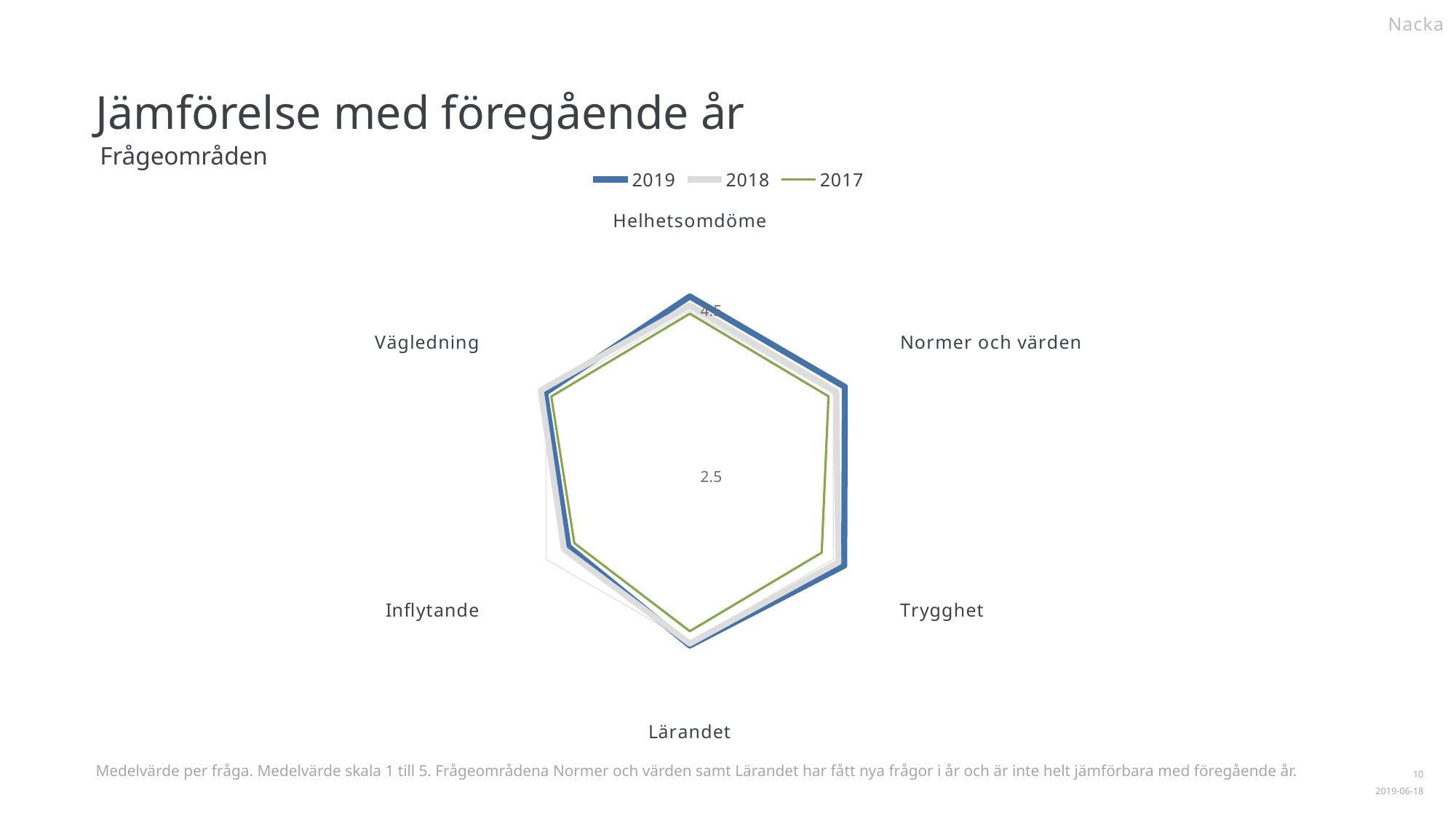
Is the 2018 value for Lärandet greater or less than 2.5? greater Is the 2019 value for Trygghet greater or less than 2.5? greater For Normer och värden, which series has the larger value, 2019 or 2017? 2019 How many series does the legend list? 3 Which years are listed in the legend? 2019, 2018, 2017 How many question areas (categories) are plotted on the radar chart? 6 Is the 2017 value for Inflytande greater or less than 2.5? greater For Helhetsomdöme, which series has the larger value, 2019 or 2017? 2019 For Inflytande, which series has the larger value, 2018 or 2019? 2018 What kind of chart is shown on the slide? Radar chart Which category is at the top of the radar chart? Helhetsomdöme